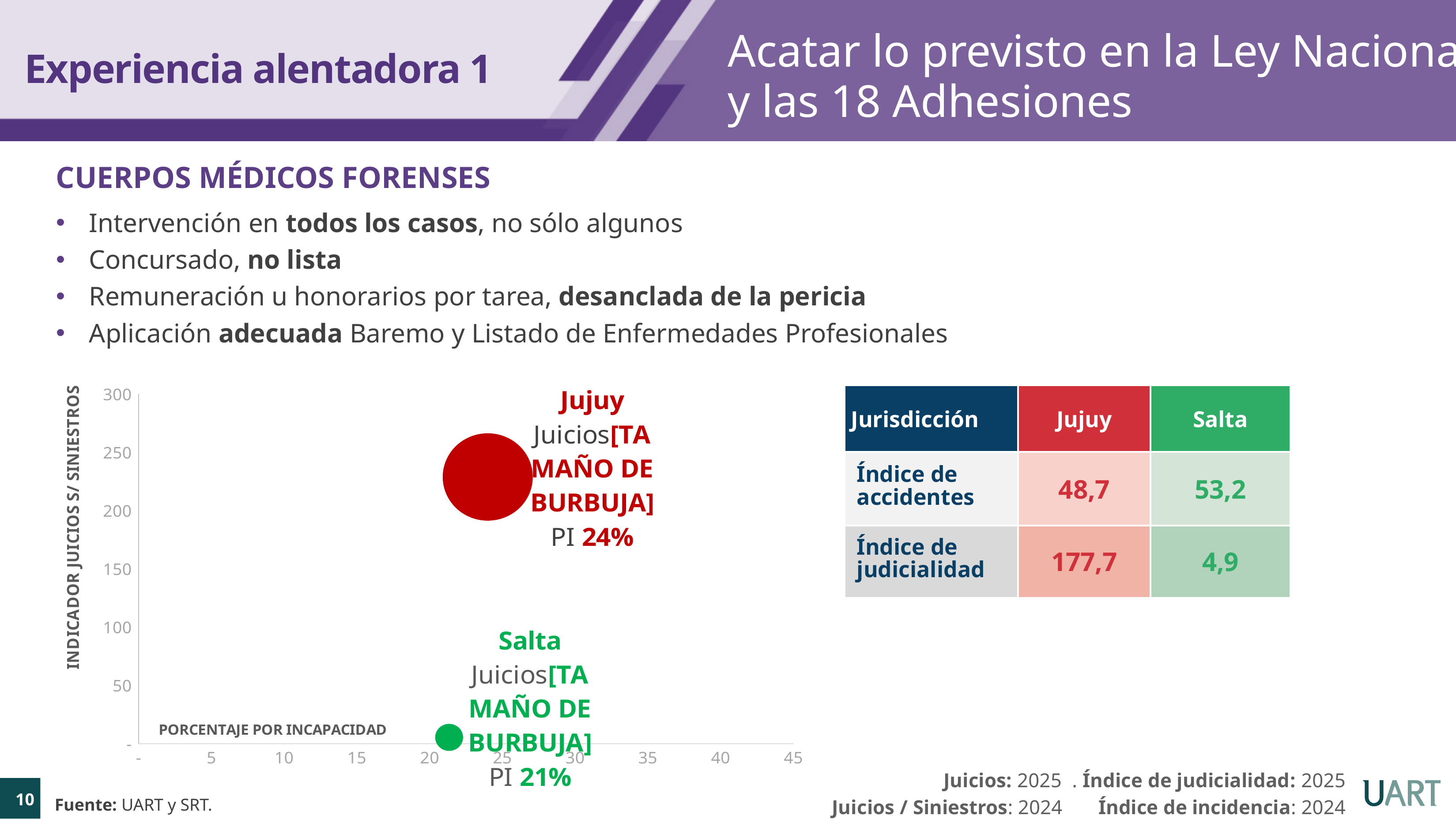
Is the 'Indicador juicios s/ siniestros' value for Salta greater or less than 50? less How many bubbles (jurisdictions) are plotted in the chart? 2 What is the PI value shown for Jujuy in the chart? 24% What kind of chart is shown on the slide? Bubble chart What is the label of the vertical axis of the chart? INDICADOR JUICIOS S/ SINIESTROS What colour is the Jujuy bubble in the chart? Red Is the 'Indicador juicios s/ siniestros' value for Jujuy greater or less than 200? greater What is the PI value shown for Salta in the chart? 21% What is the difference between the PI values of Jujuy and Salta? 3 percentage points Which jurisdiction has the lowest value on the 'Indicador juicios s/ siniestros' axis? Salta Which bubble is larger in size, Jujuy or Salta? Jujuy Which jurisdiction has the higher value on the 'Indicador juicios s/ siniestros' axis? Jujuy